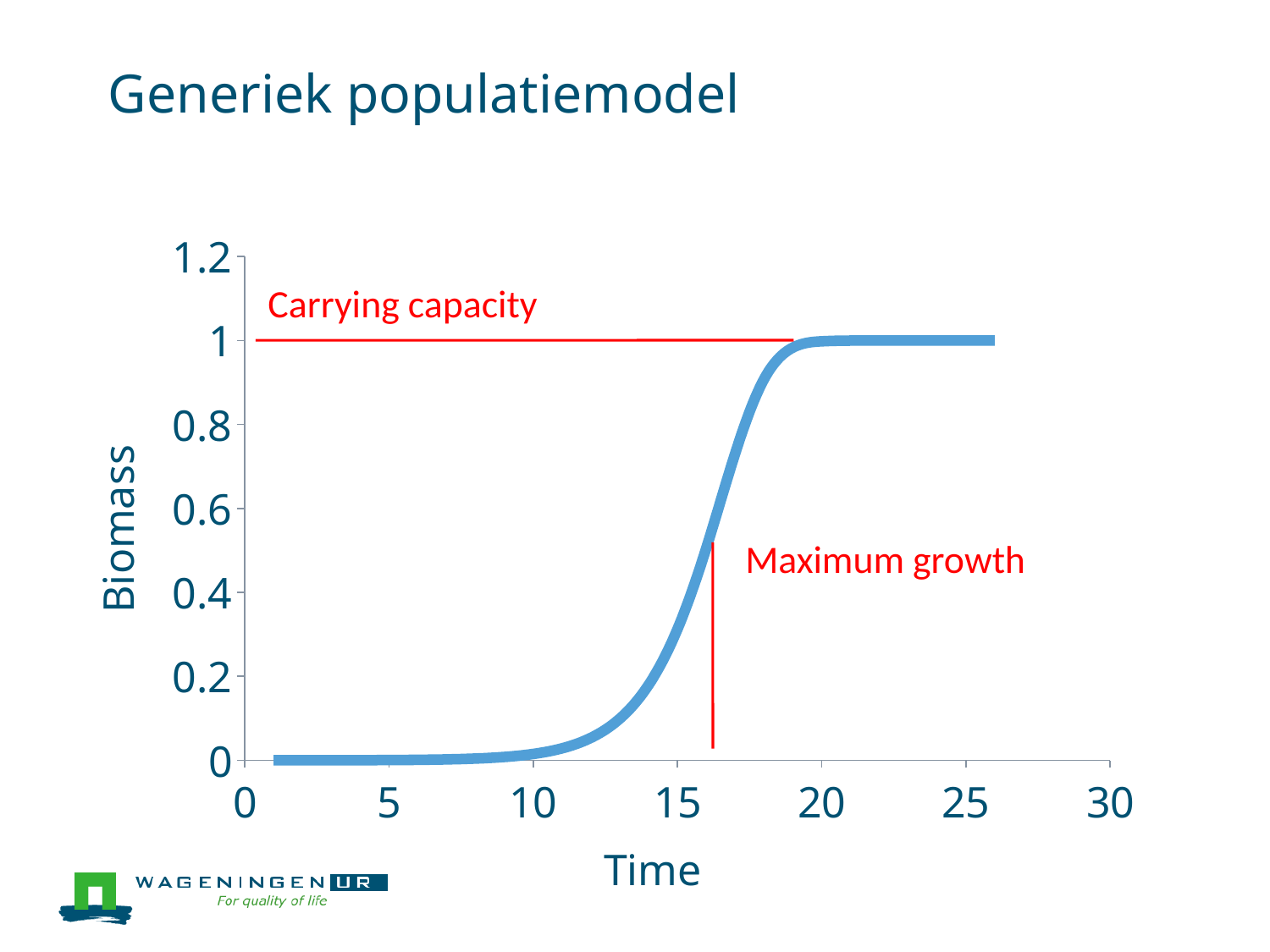
Does the Biomass curve rise or fall as Time increases? rise Is the Biomass value at Time 25 greater or less than 0.8? greater What is the label of the horizontal axis? Time Is the Biomass value at Time 10 greater or less than 0.2? less What is the highest tick value shown on the Time axis? 30 Which is larger, the Biomass at Time 15 or the Biomass at Time 20? Time 20 Is the Biomass value at Time 5 greater or less than 0.4? less What kind of chart is shown on the slide? line chart At which Biomass axis value is the red 'Carrying capacity' line drawn? 1 What is the highest tick value shown on the Biomass axis? 1.2 What is the label of the vertical axis? Biomass